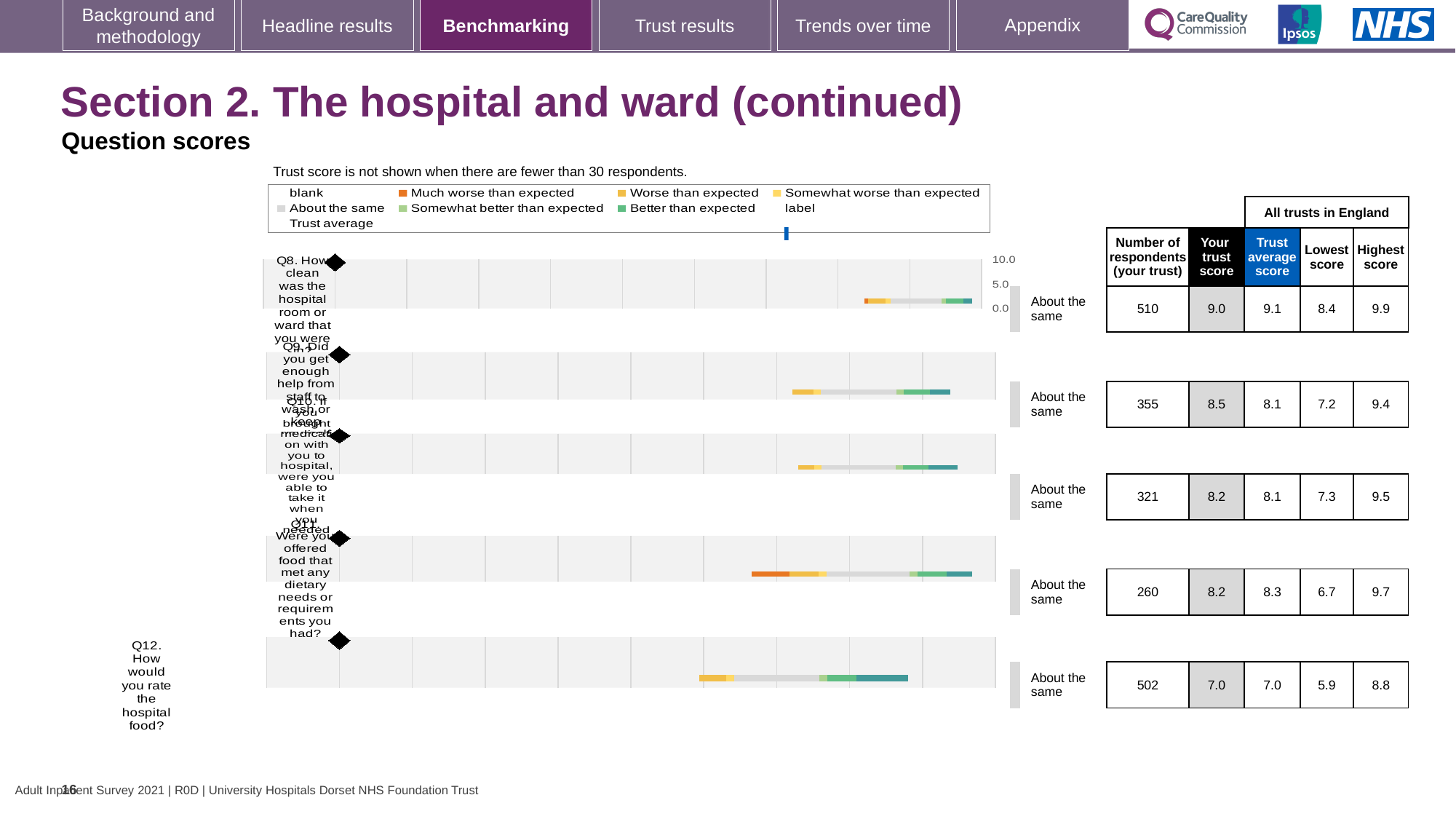
What is the trust score for Q12 (how would you rate the hospital food)? 7.0 What benchmark category is shown for every question on this slide? About the same How many questions are plotted in the chart? 5 What is the trust score for Q8 (how clean was the hospital room or ward)? 9.0 What is the lowest score across all trusts in England for Q12? 5.9 For Q9, what is the difference between the trust score and the trust average score? 0.4 What is the highest score across all trusts in England for Q8? 9.9 Which question has the highest trust score? Q8 How many respondents from the trust answered Q11 (offered food that met dietary needs)? 260 For Q11, which is larger: the trust score or the trust average score? Trust average score What kind of chart is used to show the question scores? Stacked bar chart Which question has the lowest trust score? Q12